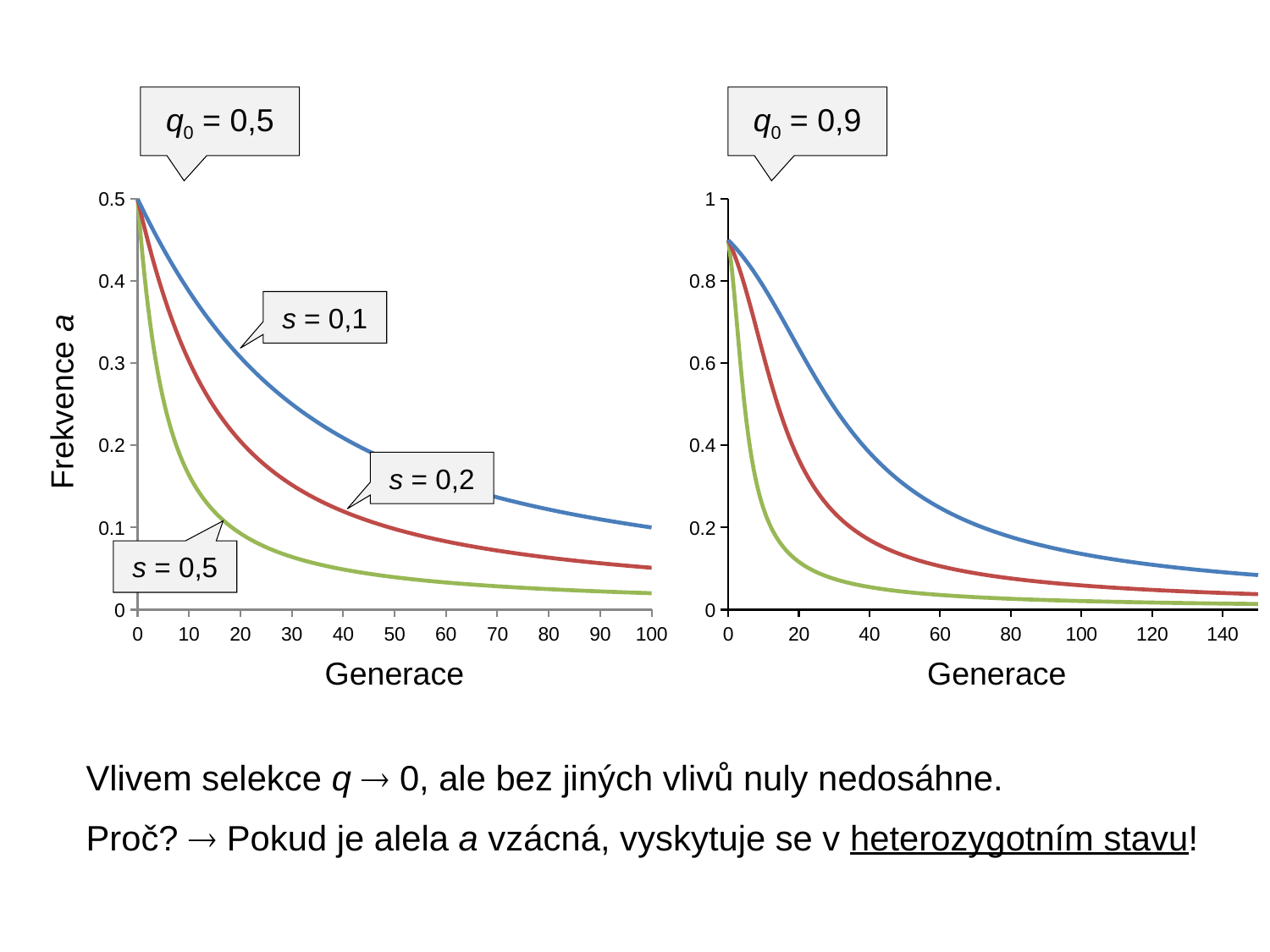
How many curves are plotted on the left chart (q0 = 0,5)? 3 What is the label of the y axis on the left chart? Frekvence a On the left chart (q0 = 0,5), is the value of the s = 0,5 curve at generation 40 greater or less than 0.1? less What is the label of the x axis on both charts? Generace On the left chart (q0 = 0,5), which curve is higher at generation 20: s = 0,1 or s = 0,5? s = 0,1 On the left chart (q0 = 0,5), what is the starting frequency of allele a at generation 0? 0,5 On the left chart (q0 = 0,5), do the curves rise or fall as the generation number increases? fall What kind of chart is the left chart (q0 = 0,5)? line chart On the right chart (q0 = 0,9), is the value of the blue curve at generation 100 greater or less than 0.2? less On the left chart (q0 = 0,5), which curve drops to the lowest frequency by generation 100? s = 0,5 On the right chart (q0 = 0,9), what is the starting frequency of allele a at generation 0? 0,9